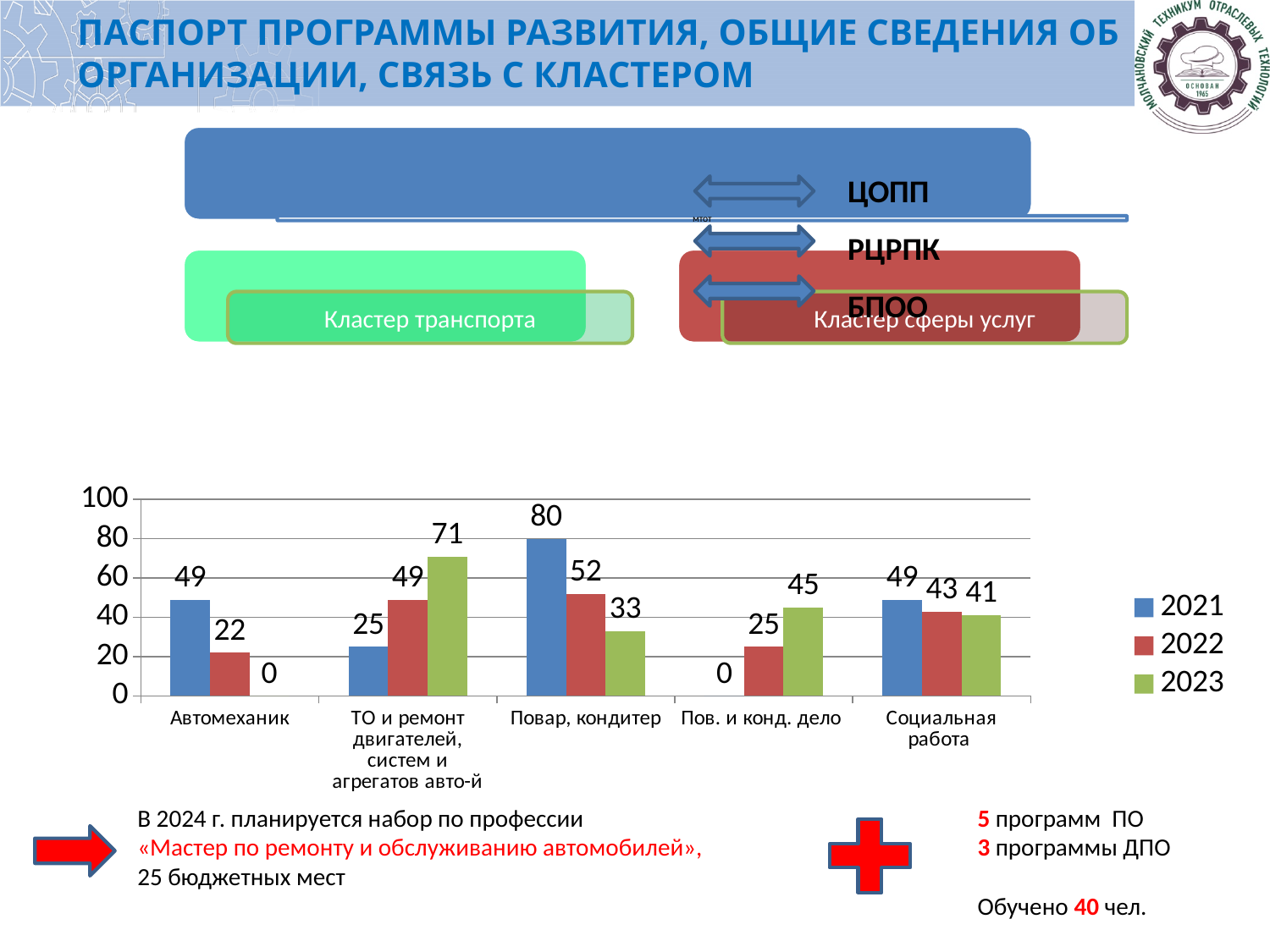
How many series does the chart legend list? 3 What is the difference between the 2021 and 2022 values for Автомеханик? 27 What is the 2022 value for Социальная работа? 43 How many categories are shown on the x axis of the chart? 5 Which colour represents the 2023 series in the chart? Green Which is larger for Пов. и конд. дело: the 2022 value or the 2023 value? 2023 What kind of chart is shown on the slide? Bar chart Which category has the highest value in the 2021 series? Повар, кондитер What is the value for Повар, кондитер in the 2021 series? 80 Which category has the lowest value in the 2023 series? Автомеханик What is the 2023 value for ТО и ремонт двигателей, систем и агрегатов авто-й? 71 Do the values for Повар, кондитер rise or fall from 2021 to 2023? Fall